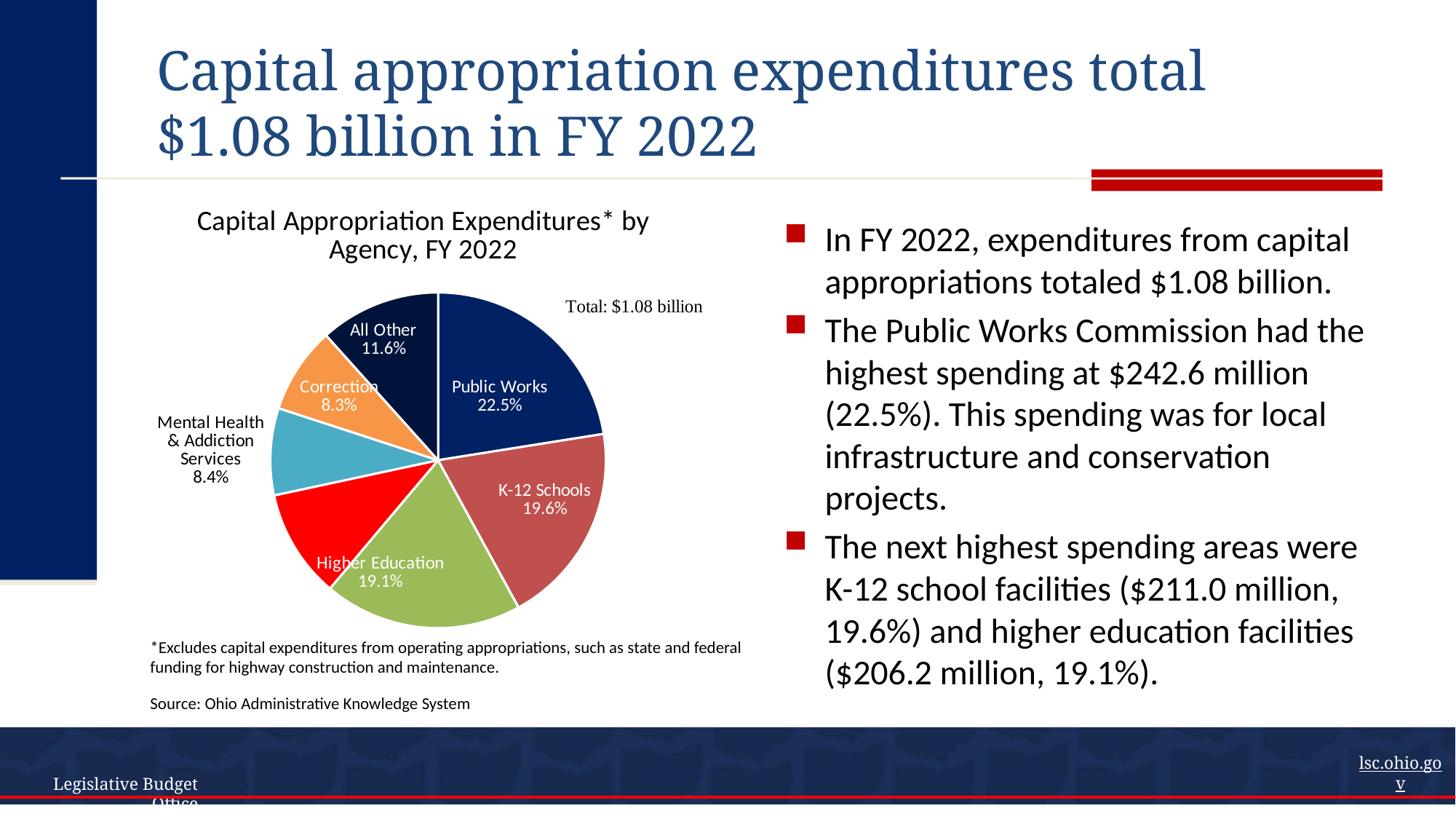
What percentage is shown for All Other? 11.6% What percentage is shown for K-12 Schools? 19.6% What share of the pie does Public Works account for? 22.5% How many percentage points larger is the Public Works share than the K-12 Schools share? 2.9 percentage points What total amount is noted next to the pie chart? Total: $1.08 billion What is the title of the chart? Capital Appropriation Expenditures* by Agency, FY 2022 What percentage is shown for Higher Education? 19.1% What percentage is shown for Mental Health & Addiction Services? 8.4% Which slice is larger, Public Works or Higher Education? Public Works What kind of chart is shown on the slide? pie chart Which agency has the largest slice of the pie? Public Works What percentage is shown for Correction? 8.3%